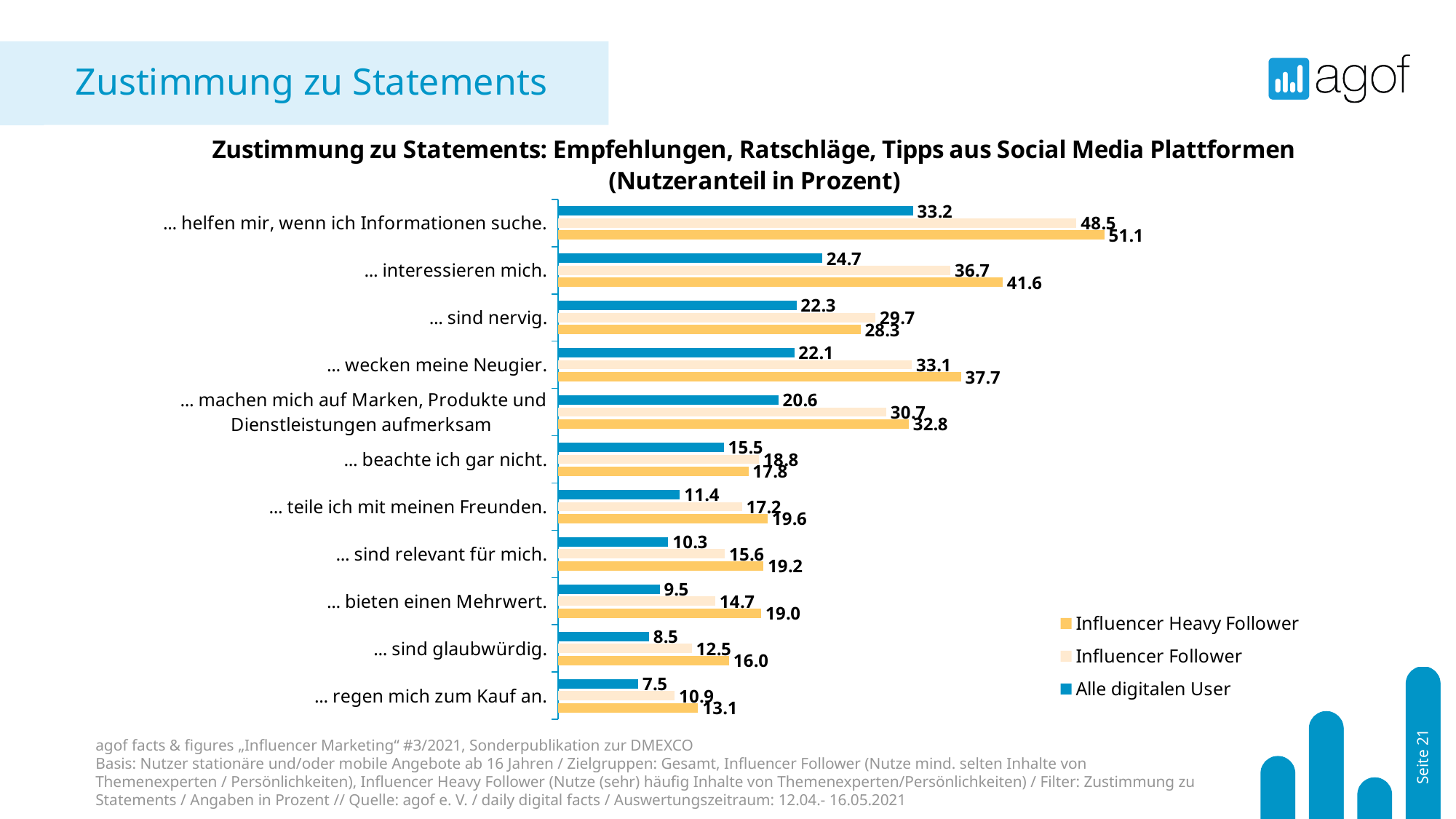
Which statement has the lowest value for "Alle digitalen User"? ... regen mich zum Kauf an. Which statement has the highest value for "Influencer Heavy Follower"? ... helfen mir, wenn ich Informationen suche. For the statement "... sind nervig.", which is larger: the value for "Influencer Follower" or for "Influencer Heavy Follower"? Influencer Follower How many series does the legend list? 3 For the statement "... beachte ich gar nicht.", which is larger: the value for "Influencer Follower" or for "Influencer Heavy Follower"? Influencer Follower What is the value for "Influencer Heavy Follower" for the statement "... sind glaubwürdig."? 16.0 How many statements (categories) are shown in the chart? 11 What is the difference between the "Influencer Heavy Follower" and "Alle digitalen User" values for "... interessieren mich."? 16.9 What type of chart is shown on the slide? bar chart Which colour represents the series "Alle digitalen User" in the chart? blue What is the value for "Alle digitalen User" for the statement "... helfen mir, wenn ich Informationen suche."? 33.2 What is the value for "Influencer Follower" for the statement "... wecken meine Neugier."? 33.1